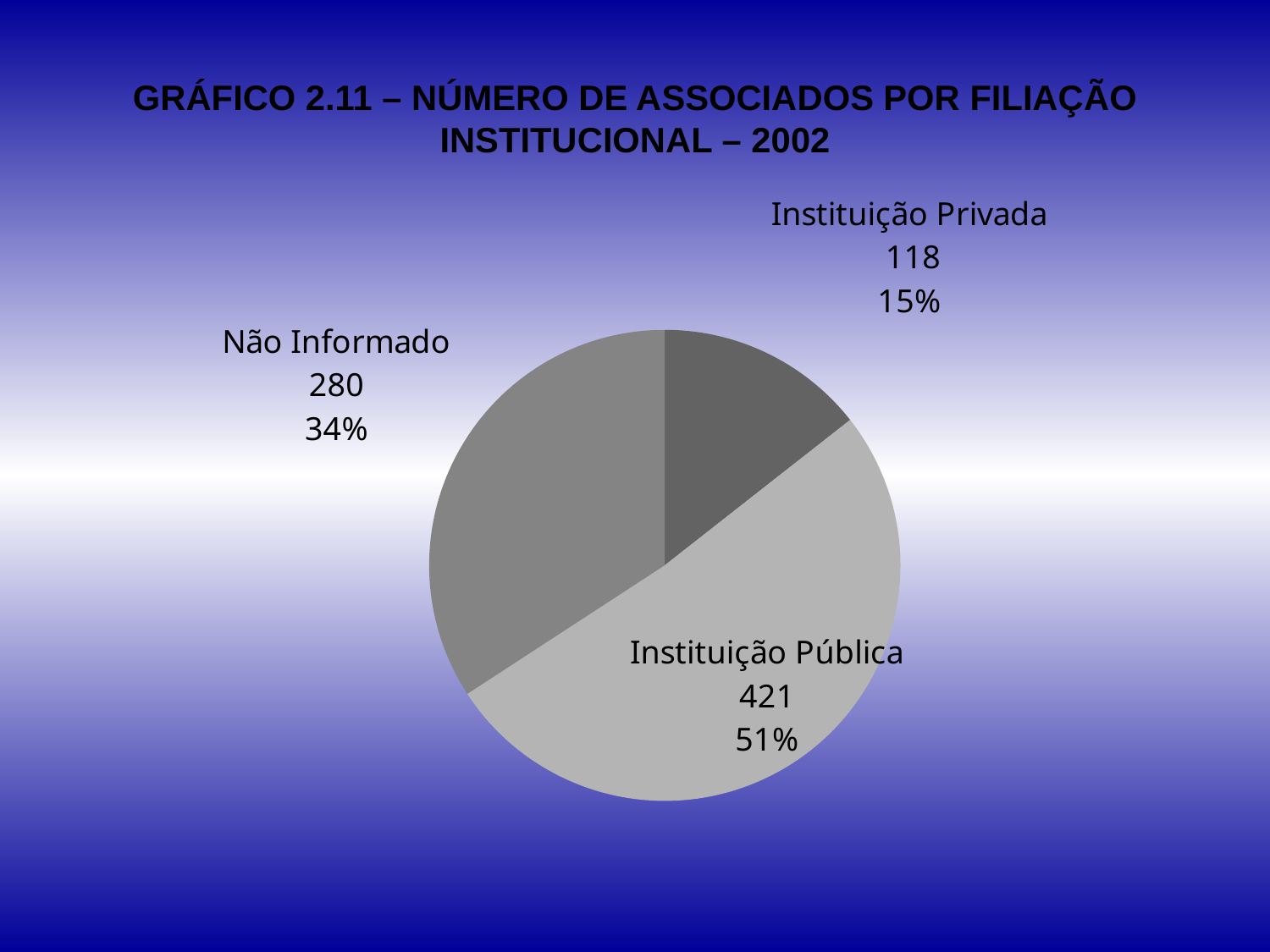
What share of the pie does Não Informado represent? 34% What is the number of associates for Instituição Pública? 421 What type of chart is shown on the slide? pie chart Which category has the largest number of associates? Instituição Pública What is the number of associates for Instituição Privada? 118 What is the number of associates for Não Informado? 280 How many slices does the pie chart have? 3 What share of the pie does Instituição Pública represent? 51% What is the difference between the number of associates for Instituição Pública and Não Informado? 141 What share of the pie does Instituição Privada represent? 15% Which category has the smallest number of associates? Instituição Privada Which is larger, the number of associates for Não Informado or for Instituição Privada? Não Informado